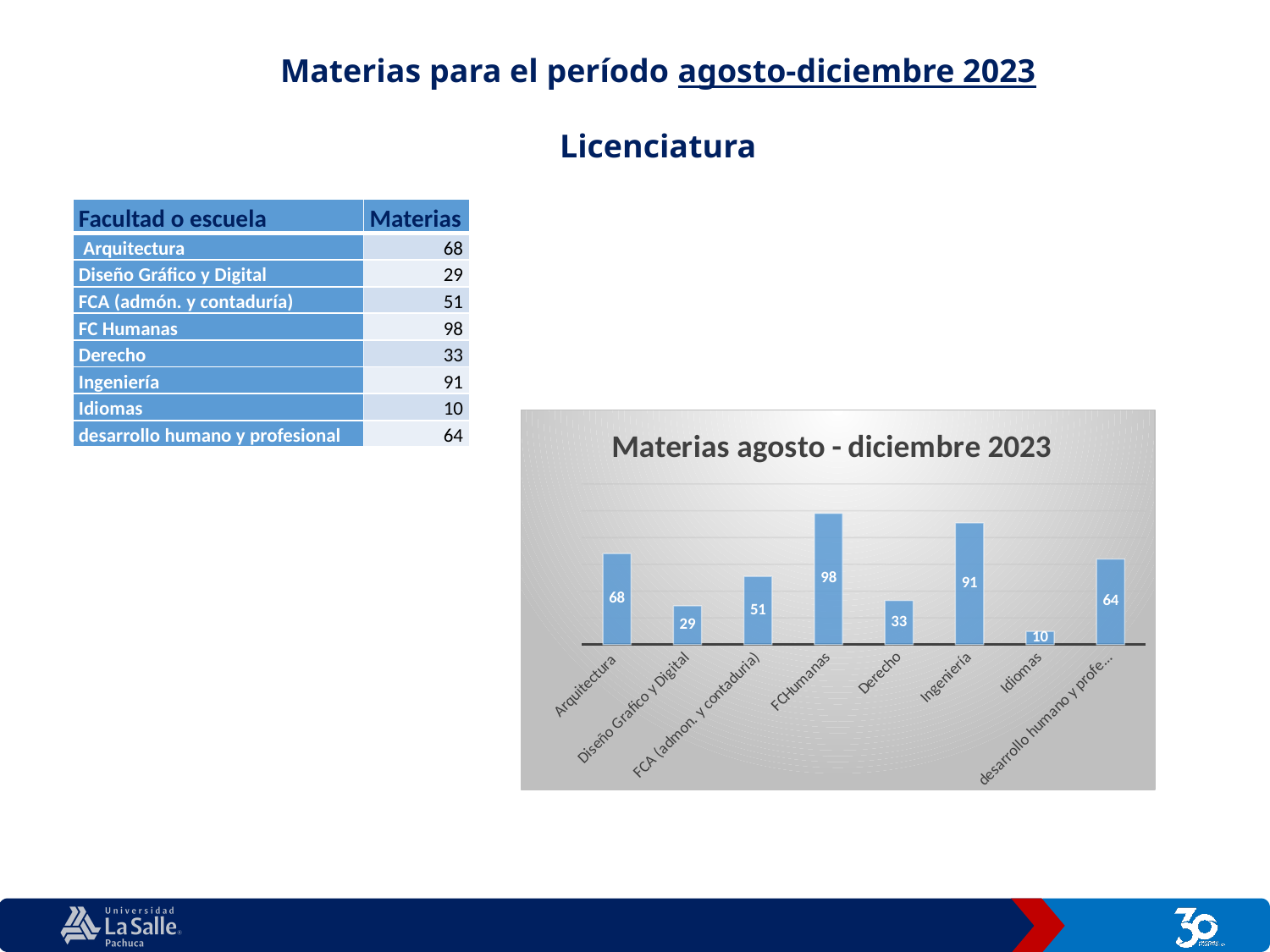
Which category has the lowest value in the chart? Idiomas What kind of chart is shown on the slide? Bar chart What is the difference between the values for FCA (admón. y contaduría) and Derecho? 18 Which category has the highest value in the chart? FC Humanas What is the value for FC Humanas in the chart? 98 What is the value for Diseño Gráfico y Digital in the chart? 29 What colour are the bars in the chart? Blue What is the difference between the values for Ingeniería and Arquitectura? 23 Which is larger, the value for Arquitectura or the value for desarrollo humano y profesional? Arquitectura What is the title of the chart? Materias agosto - diciembre 2023 How many categories are shown in the chart? 8 What is the value for Derecho in the chart? 33